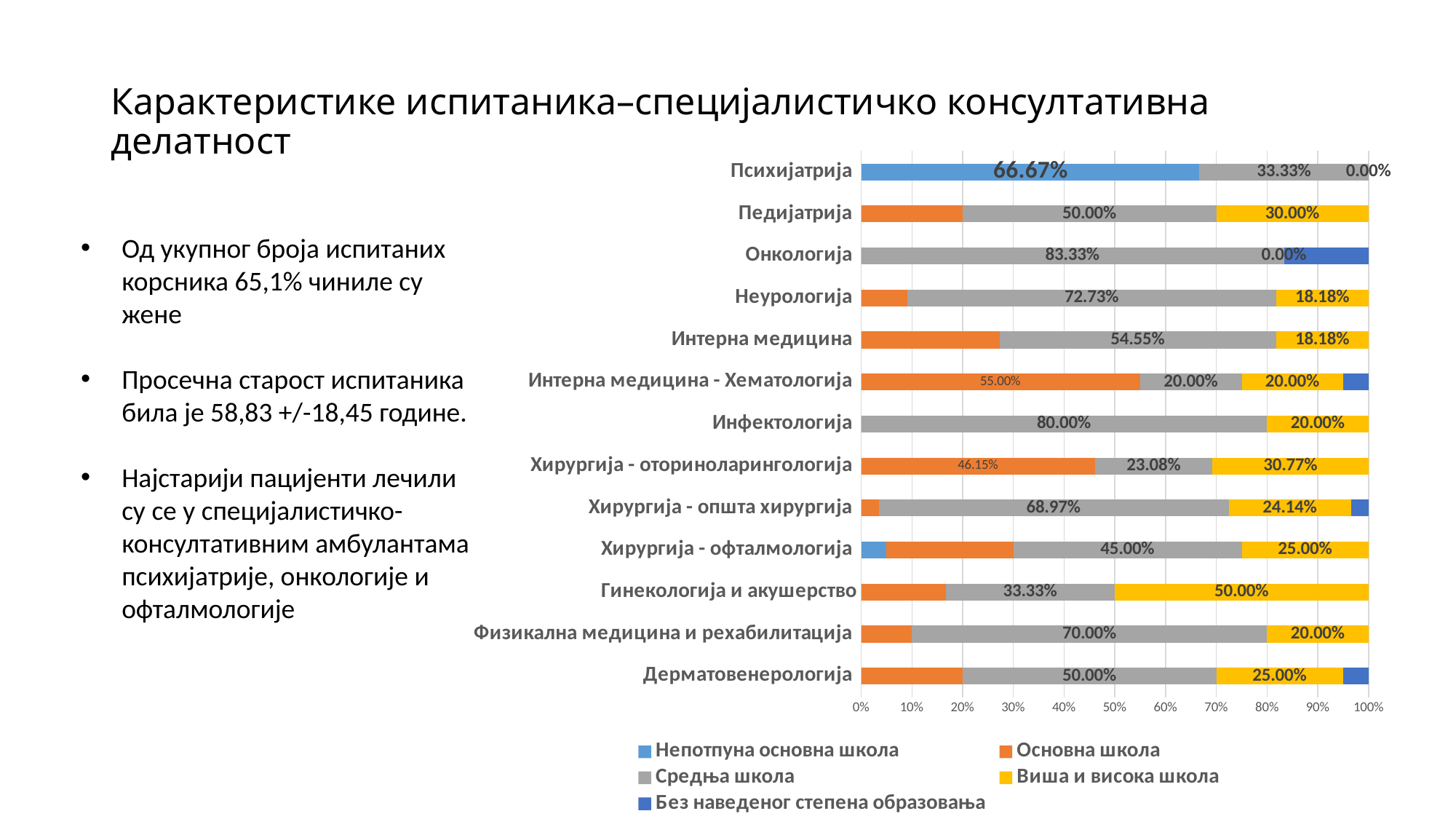
What is the value of the Непотпуна основна школа segment for Психијатрија? 66.67% Which specialty has the highest Виша и висока школа share? Гинекологија и акушерство Is the Основна школа value for Интерна медицина greater or less than 20%? greater Which is larger: the Средња школа value for Неурологија or for Физикална медицина и рехабилитација? Неурологија Which specialty has the highest Средња школа share? Онкологија What is the value of the Основна школа segment for Интерна медицина - Хематологија? 55.00% How many series does the chart legend list? 5 What is the difference between the Виша и висока школа values for Хирургија - оториноларингологија and Хирургија - општа хирургија? 6.63% How many specialties (categories) are listed on the chart? 13 What is the value of the Виша и висока школа segment for Гинекологија и акушерство? 50.00% What type of chart is shown on the slide? Stacked bar chart What is the value of the Средња школа segment for Онкологија? 83.33%